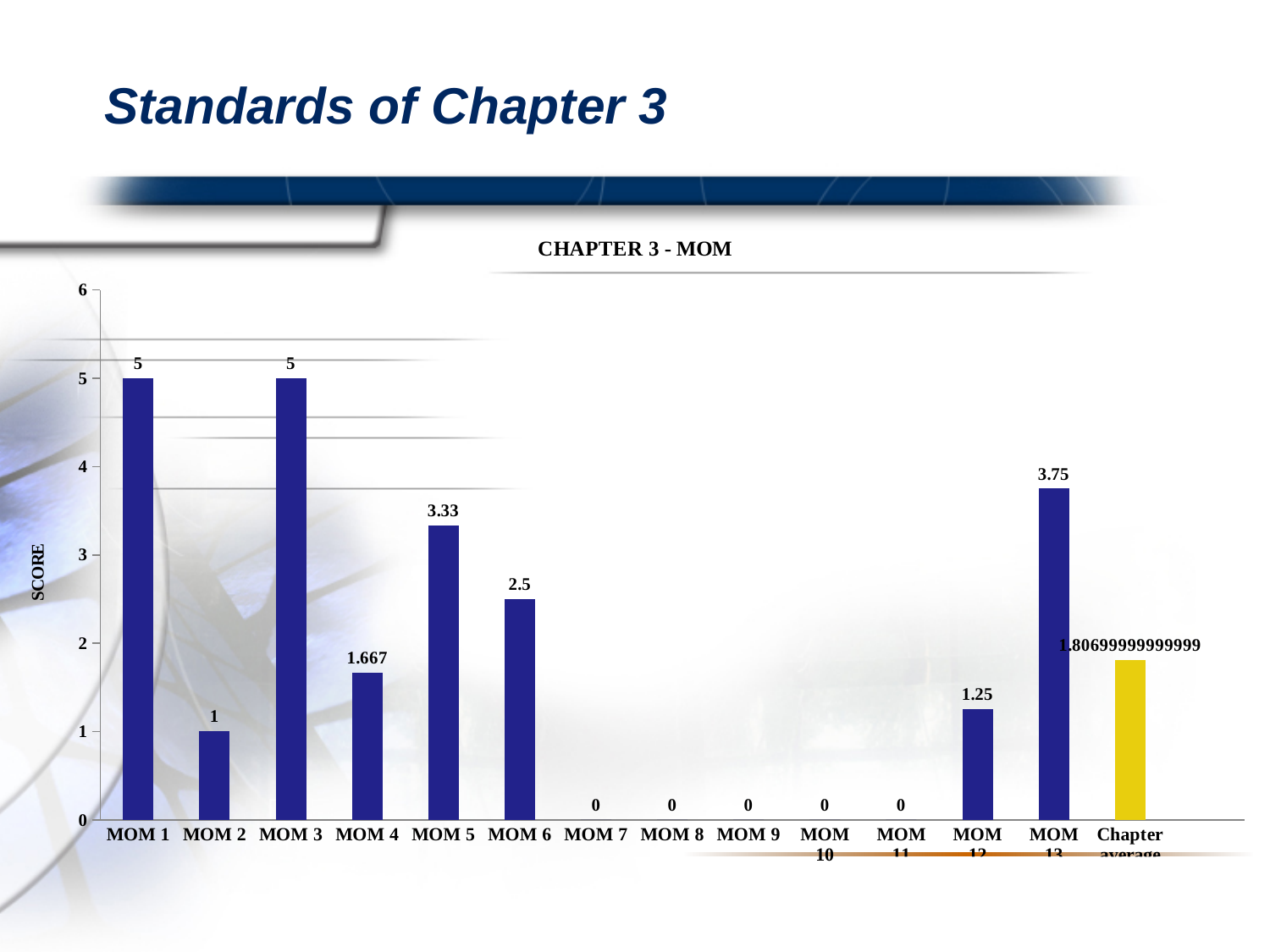
What is the score for MOM 13? 3.75 What is the highest score shown on the chart? 5 Which has a higher score, MOM 5 or MOM 6? MOM 5 Is the value for Chapter average greater or less than 2? less What is the label on the vertical axis? SCORE What kind of chart is shown on the slide? bar chart What is the score for MOM 12? 1.25 What is the score for MOM 4? 1.667 What is the difference between the scores for MOM 13 and MOM 12? 2.5 How many categories are shown on the x axis? 14 What is the score for MOM 5? 3.33 What is the difference between the scores for MOM 1 and MOM 6? 2.5